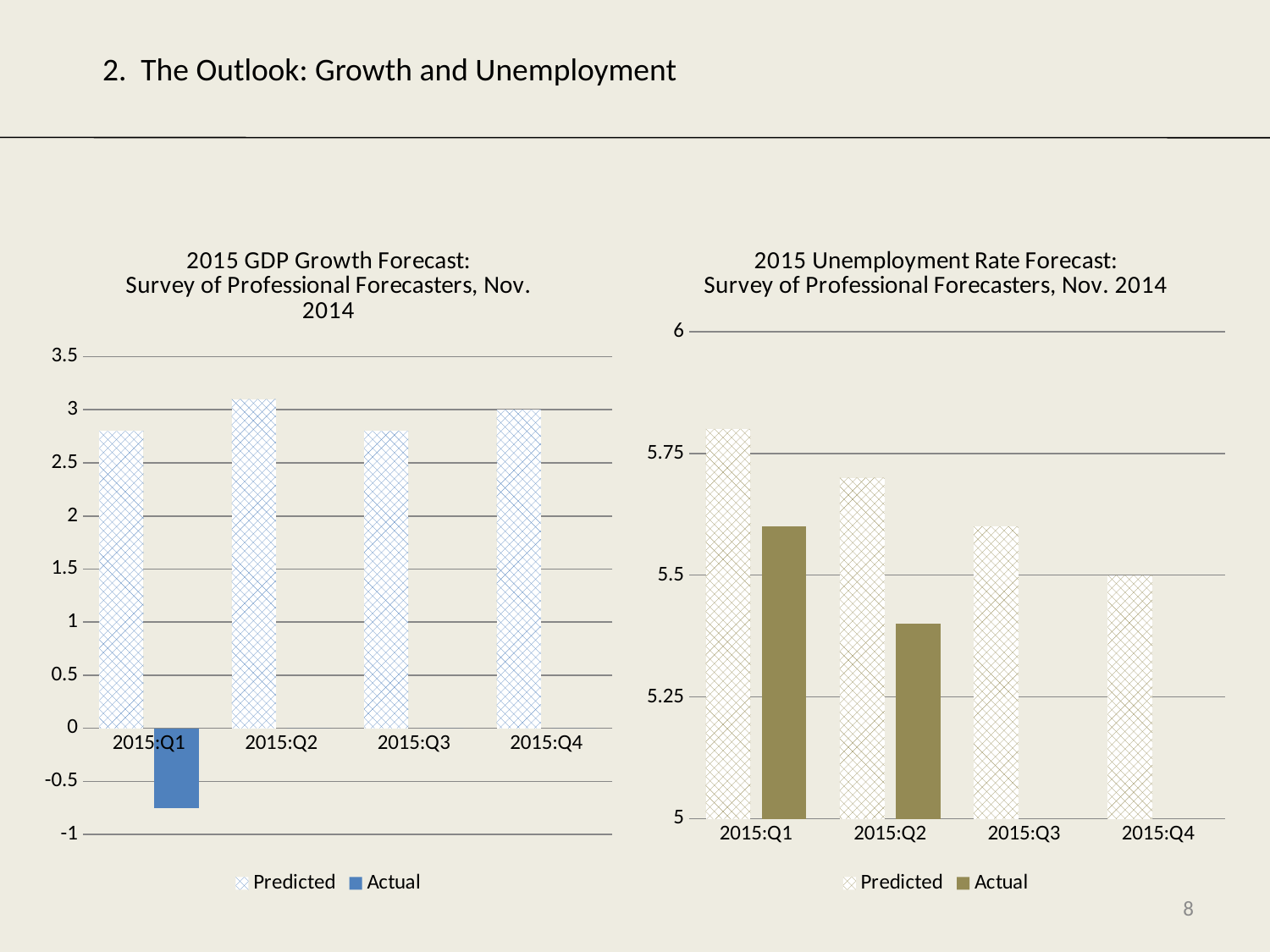
How many quarters are shown on the x axis of the 2015 GDP Growth Forecast chart? 4 In the 2015 GDP Growth Forecast chart, is the Predicted value for 2015:Q2 greater or less than 3? greater In the 2015 Unemployment Rate Forecast chart, which is larger for 2015:Q2, the Predicted or the Actual value? Predicted In the 2015 GDP Growth Forecast chart, which quarter has the highest Predicted value? 2015:Q2 In the 2015 Unemployment Rate Forecast chart, which quarter has the lowest Predicted value? 2015:Q4 In the 2015 Unemployment Rate Forecast chart, which quarter has the highest Predicted value? 2015:Q1 In the 2015 GDP Growth Forecast chart, is the Actual value for 2015:Q1 greater or less than 0? less What kind of chart is the 2015 GDP Growth Forecast chart on the left? bar chart In the 2015 Unemployment Rate Forecast chart, do the Predicted values rise or fall from 2015:Q1 to 2015:Q4? fall In the 2015 Unemployment Rate Forecast chart, how many quarters have an Actual bar? 2 In the 2015 Unemployment Rate Forecast chart, is the Actual value for 2015:Q2 greater or less than 5.5? less How many series does the legend of the 2015 Unemployment Rate Forecast chart list? 2